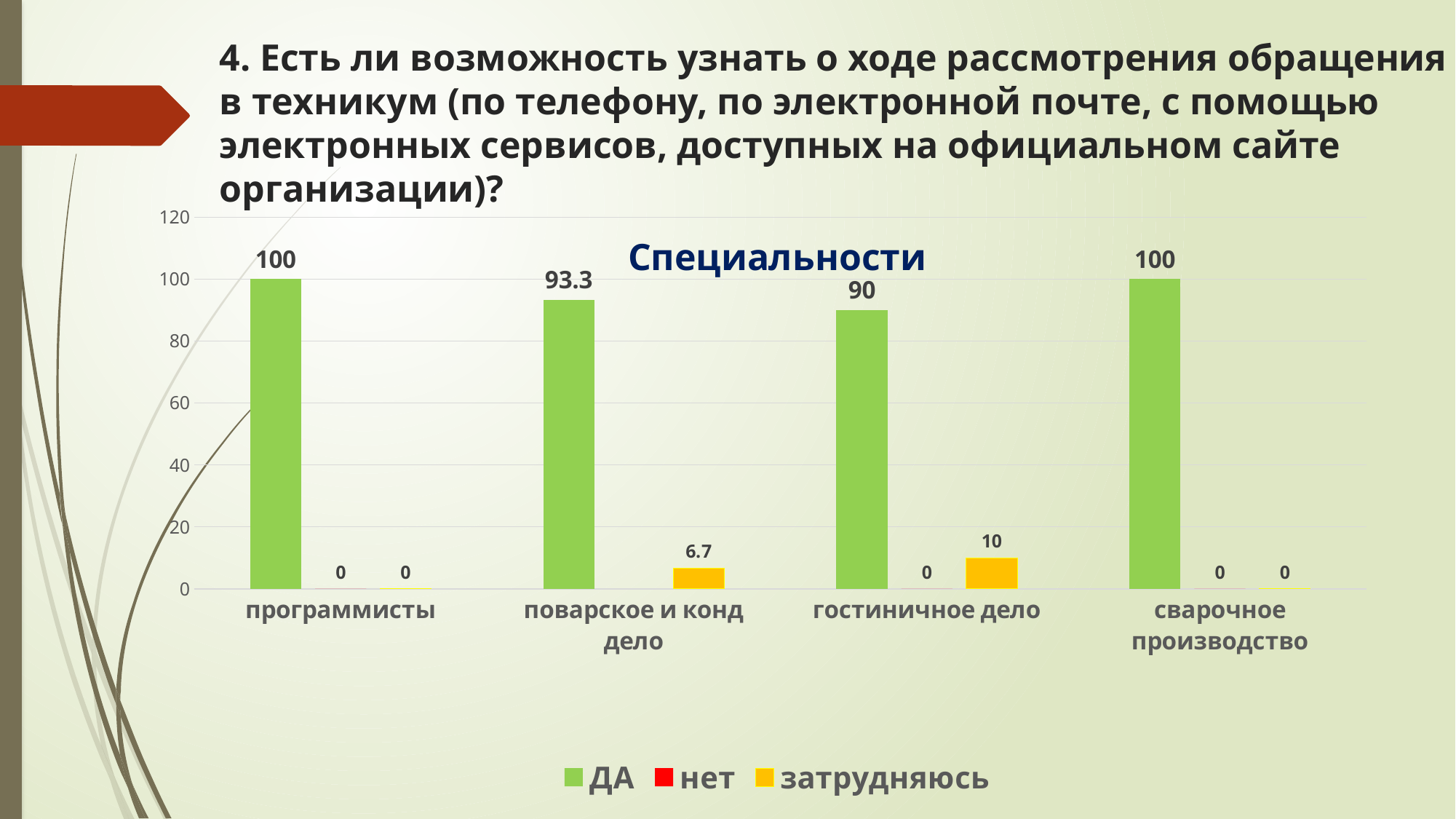
Which is larger: the затрудняюсь value for гостиничное дело or for поварское и конд дело? гостиничное дело How many series does the legend list? 3 What is the value of затрудняюсь for гостиничное дело? 10 Which category has the lowest ДА value? гостиничное дело What type of chart is shown on the slide? bar chart What is the difference between the ДА values for программисты and гостиничное дело? 10 What is the value of ДА for гостиничное дело? 90 What is the title of the chart? Специальности What is the value of ДА for программисты? 100 What is the value of ДА for поварское и конд дело? 93.3 What is the value of затрудняюсь for поварское и конд дело? 6.7 How many categories are shown on the x axis? 4